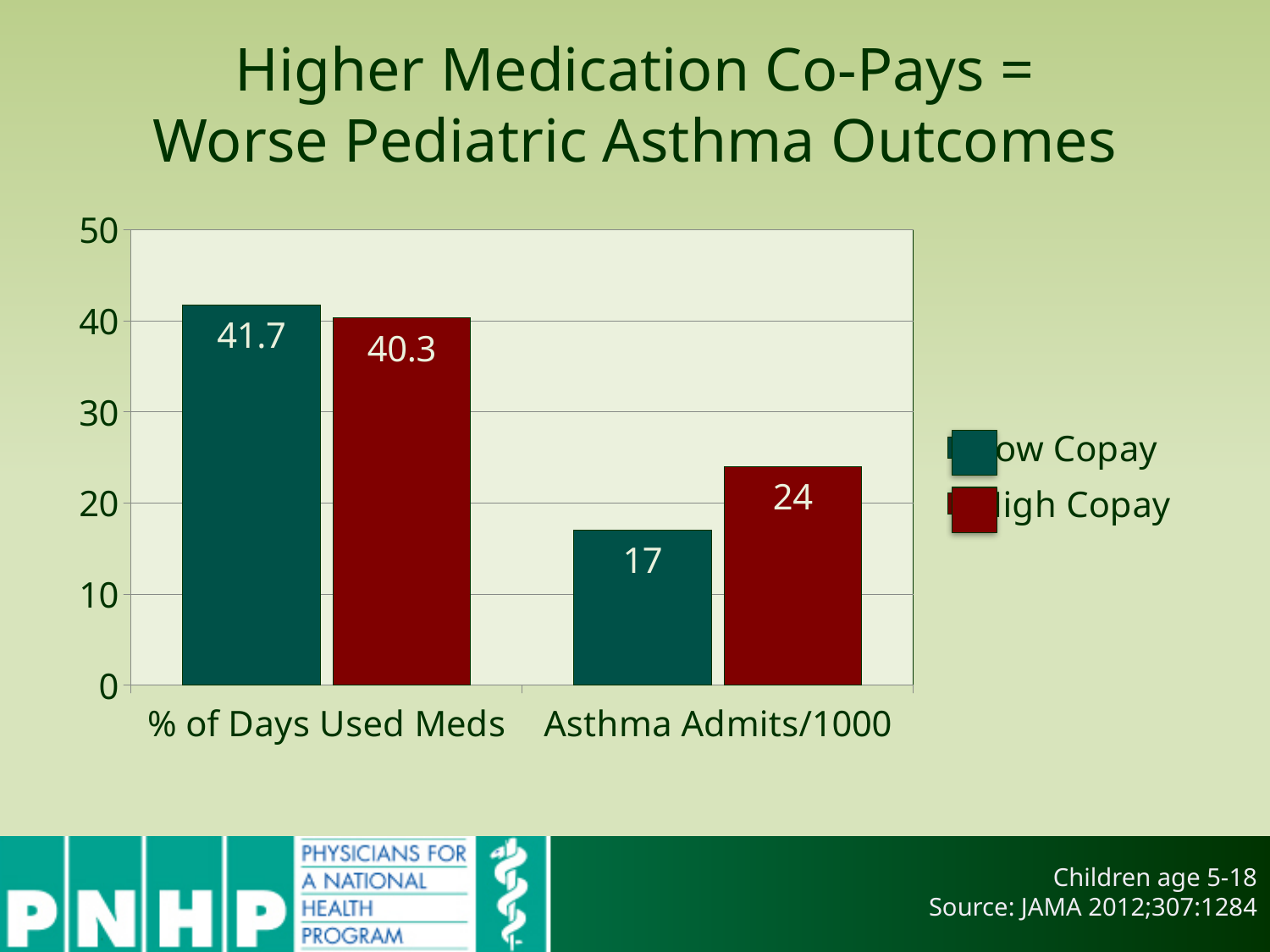
What is the value for High Copay in the % of Days Used Meds category? 40.3 What is the value for Low Copay in the Asthma Admits/1000 category? 17 Which category has the lowest Low Copay value? Asthma Admits/1000 What is the difference between the Low Copay and High Copay values for % of Days Used Meds? 1.4 What is the title of the slide? Higher Medication Co-Pays = Worse Pediatric Asthma Outcomes How many categories are shown on the x axis? 2 For Asthma Admits/1000, which series has the larger value, Low Copay or High Copay? High Copay What is the value for Low Copay in the % of Days Used Meds category? 41.7 How many series does the legend list? 2 What is the value for High Copay in the Asthma Admits/1000 category? 24 What is the difference between the High Copay and Low Copay values for Asthma Admits/1000? 7 What kind of chart is shown on the slide? Bar chart